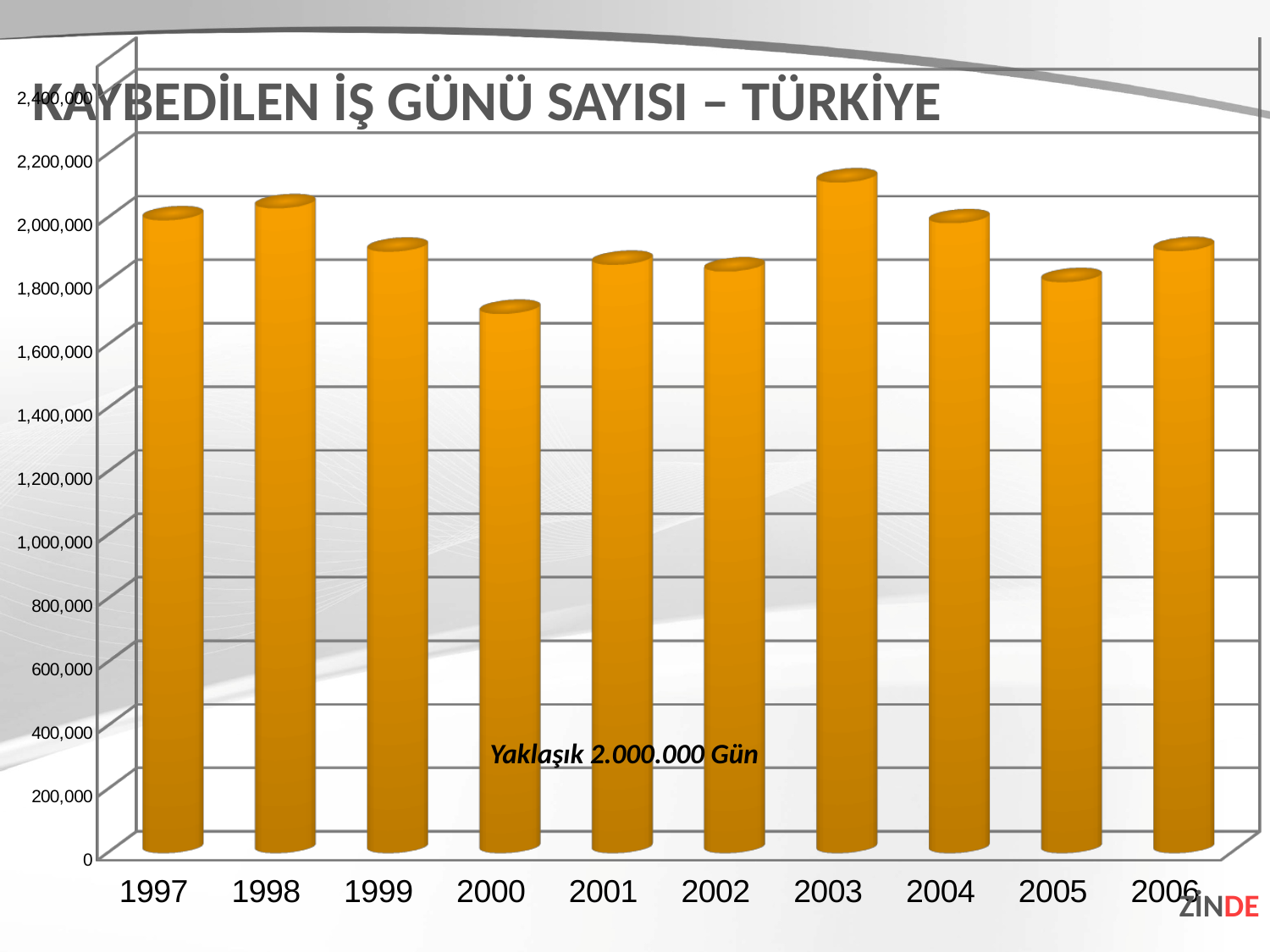
Which year has the highest number of lost working days? 2003 Is the value for 1999 greater or less than 1,800,000? greater Is the value for 2000 greater or less than 1,800,000? less What text annotation is printed inside the chart area? Yaklaşık 2.000.000 Gün How many years are shown on the x axis of the chart? 10 Which year has the lowest number of lost working days? 2000 What kind of chart is shown on the slide? bar chart What is the title of the chart? KAYBEDİLEN İŞ GÜNÜ SAYISI – TÜRKİYE Is the value for 2003 greater or less than 2,000,000? greater Does the value rise or fall from 2002 to 2003? rise Which year has the larger value, 1998 or 1999? 1998